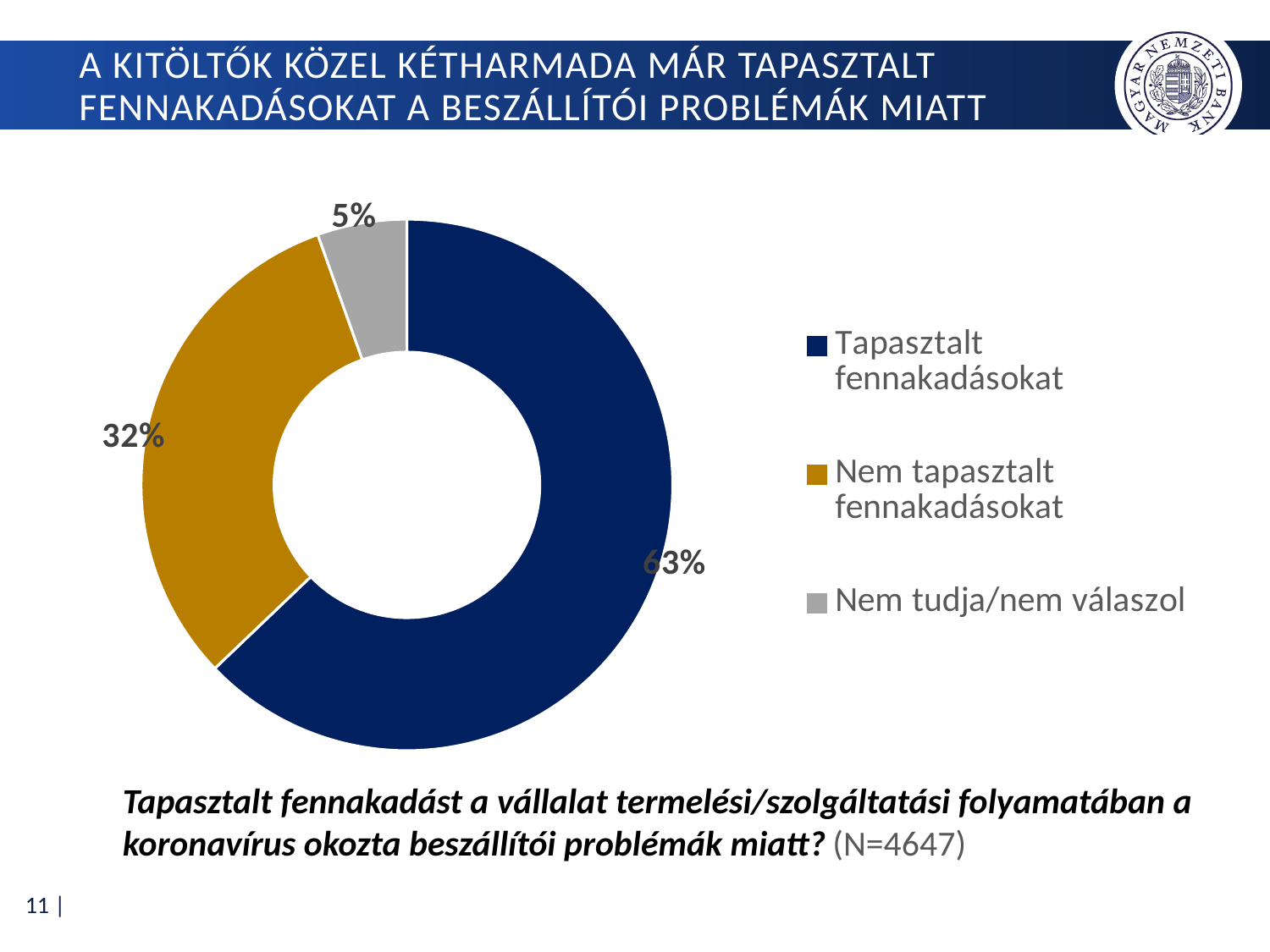
What share of respondents answered "Nem tudja/nem válaszol"? 5% What share of respondents answered "Nem tapasztalt fennakadásokat"? 32% What share of respondents answered "Tapasztalt fennakadásokat"? 63% What kind of chart is shown on the slide? Pie chart (doughnut) What is the difference in percentage points between "Tapasztalt fennakadásokat" and "Nem tapasztalt fennakadásokat"? 31 percentage points How many entries does the legend list? 3 Which category has the largest share of the pie? Tapasztalt fennakadásokat What is the sample size (N) stated below the chart? N=4647 Which is larger: the share for "Nem tapasztalt fennakadásokat" or for "Nem tudja/nem válaszol"? Nem tapasztalt fennakadásokat Which category has the smallest share of the pie? Nem tudja/nem válaszol How many categories does the pie chart show? 3 What colour is the slice for "Nem tapasztalt fennakadásokat"? Gold/yellow